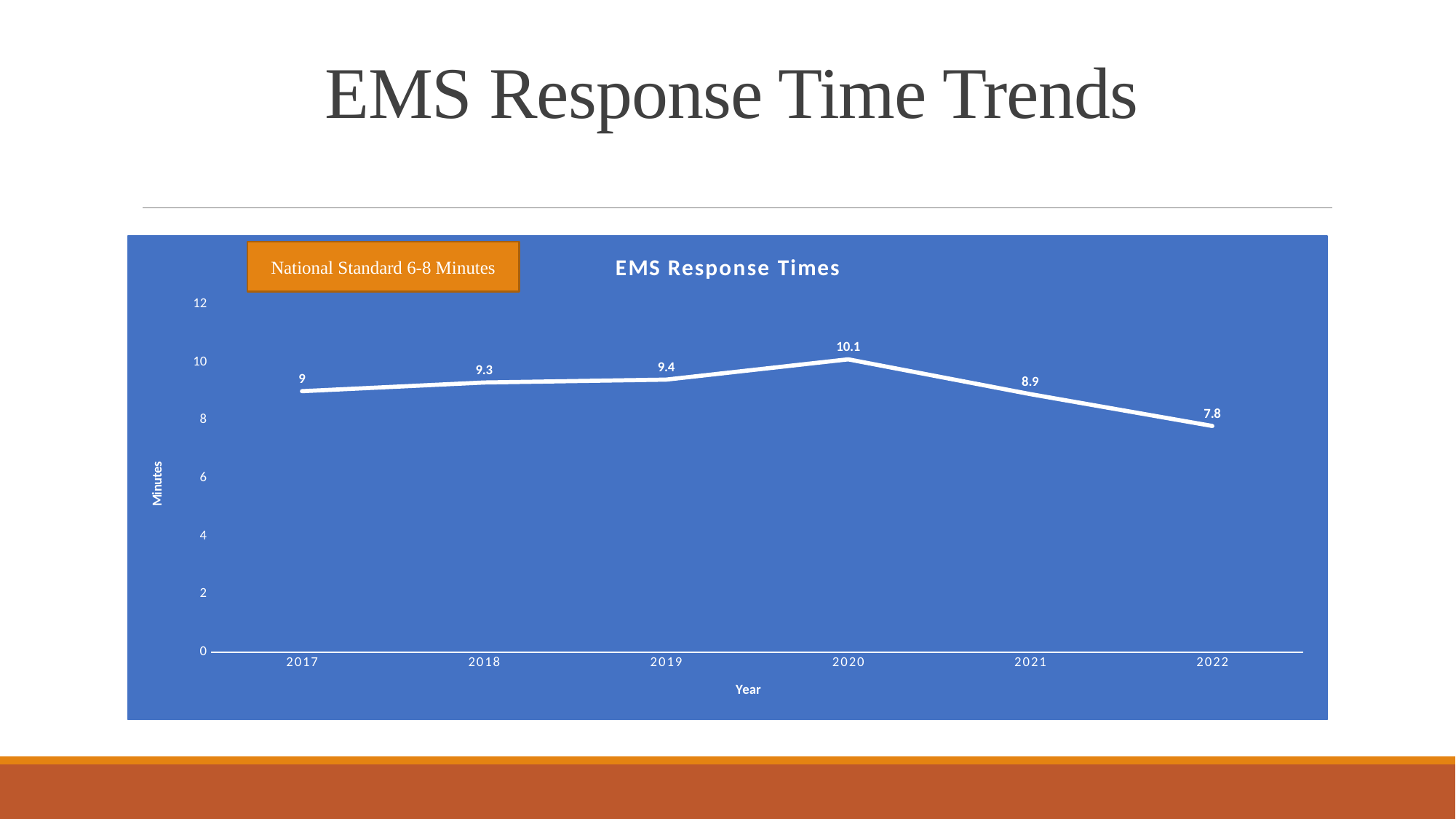
What is the difference between the response times in 2020 and 2022? 2.3 Is the response time for 2021 greater or less than 8? greater Which year has a higher response time, 2019 or 2021? 2019 What is the EMS response time for 2017? 9 What is the EMS response time for 2022? 7.8 Do the response times rise or fall from 2020 to 2022? fall Which year has the lowest EMS response time? 2022 What is the EMS response time for 2020? 10.1 Which year has the highest EMS response time? 2020 How many years are plotted on the chart? 6 What is the title of the chart? EMS Response Times What kind of chart is shown on the slide? line chart